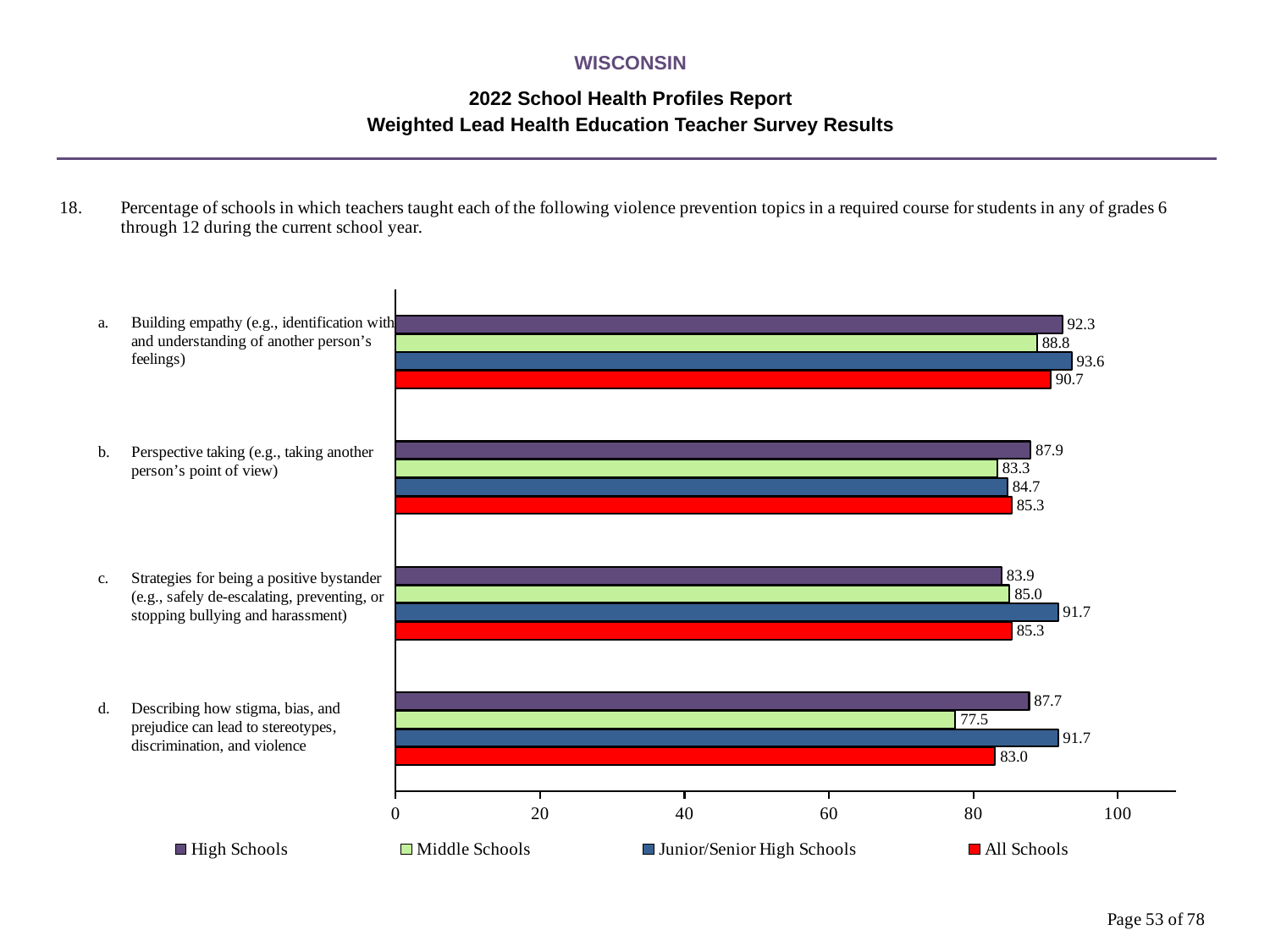
What is the difference between the High Schools and Middle Schools values for topic d? 10.2 What kind of chart is shown on the slide? bar chart Which topic has the lowest value for Middle Schools? d. Describing how stigma, bias, and prejudice can lead to stereotypes, discrimination, and violence What is the value for Middle Schools for topic d (Describing how stigma, bias, and prejudice can lead to stereotypes, discrimination, and violence)? 77.5 For topic c (Strategies for being a positive bystander), which is larger: the High Schools value or the Junior/Senior High Schools value? Junior/Senior High Schools How many violence prevention topics are shown in the chart? 4 Is the Middle Schools value for topic d greater or less than 80? less Which colour represents All Schools in the legend? red How many series does the legend list? 4 What is the All Schools value for topic b (Perspective taking)? 85.3 What is the value for Junior/Senior High Schools for topic a (Building empathy)? 93.6 Which topic has the highest value for High Schools? a. Building empathy